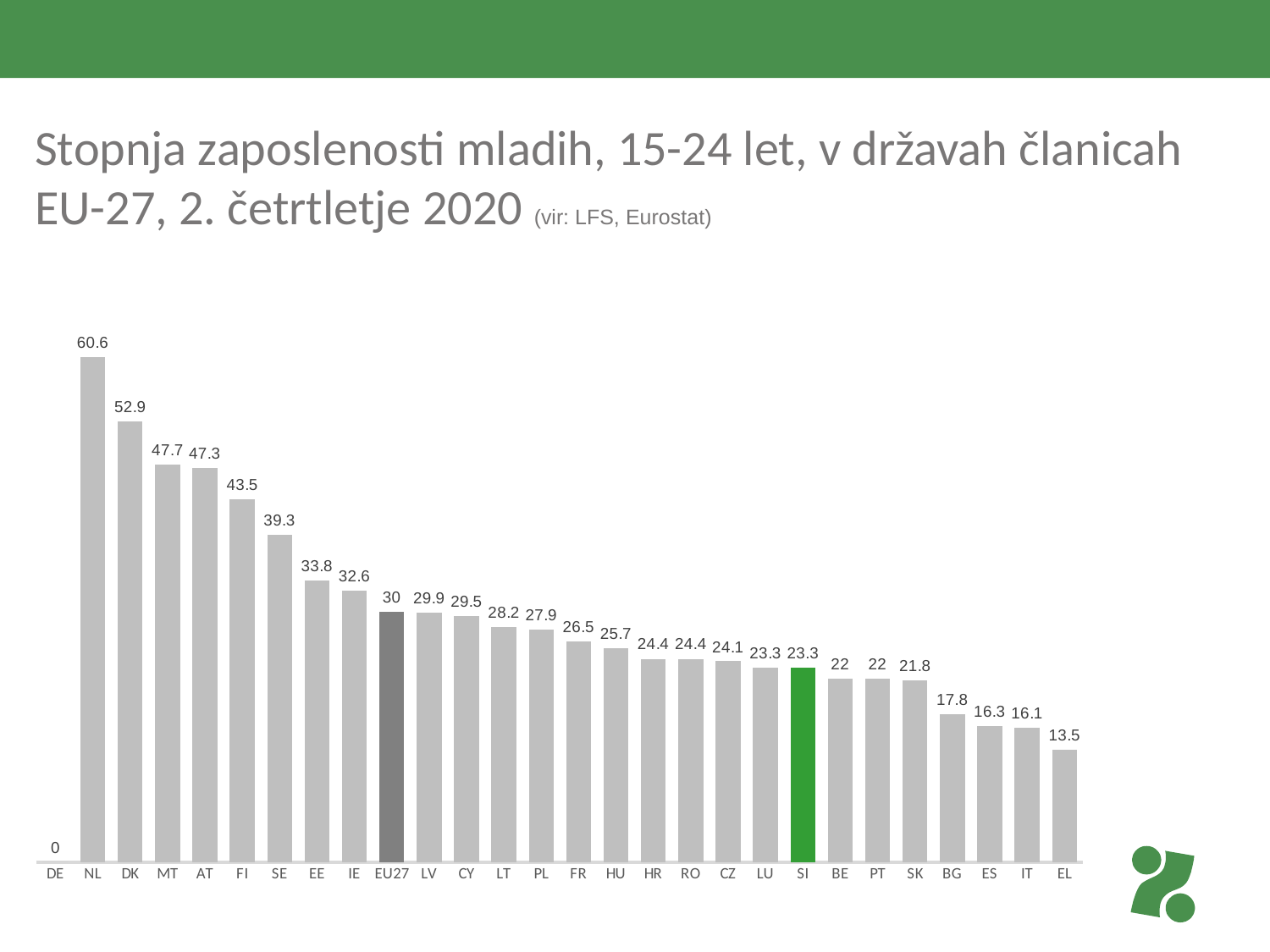
What is the value for EU27? 30 What value is shown for DE? 0 Which country's bar is coloured bright green? SI Which country has the highest value? NL How many categories are shown on the x axis? 28 Do the values rise or fall from NL to EL along the x axis? fall What is the difference between the values for EU27 and SI? 6.7 Excluding DE, which country has the lowest value? EL What is the difference between the values for NL and DK? 7.7 What kind of chart is this? bar chart Which is larger, the value for FI or the value for SE? FI What is the value for SI? 23.3